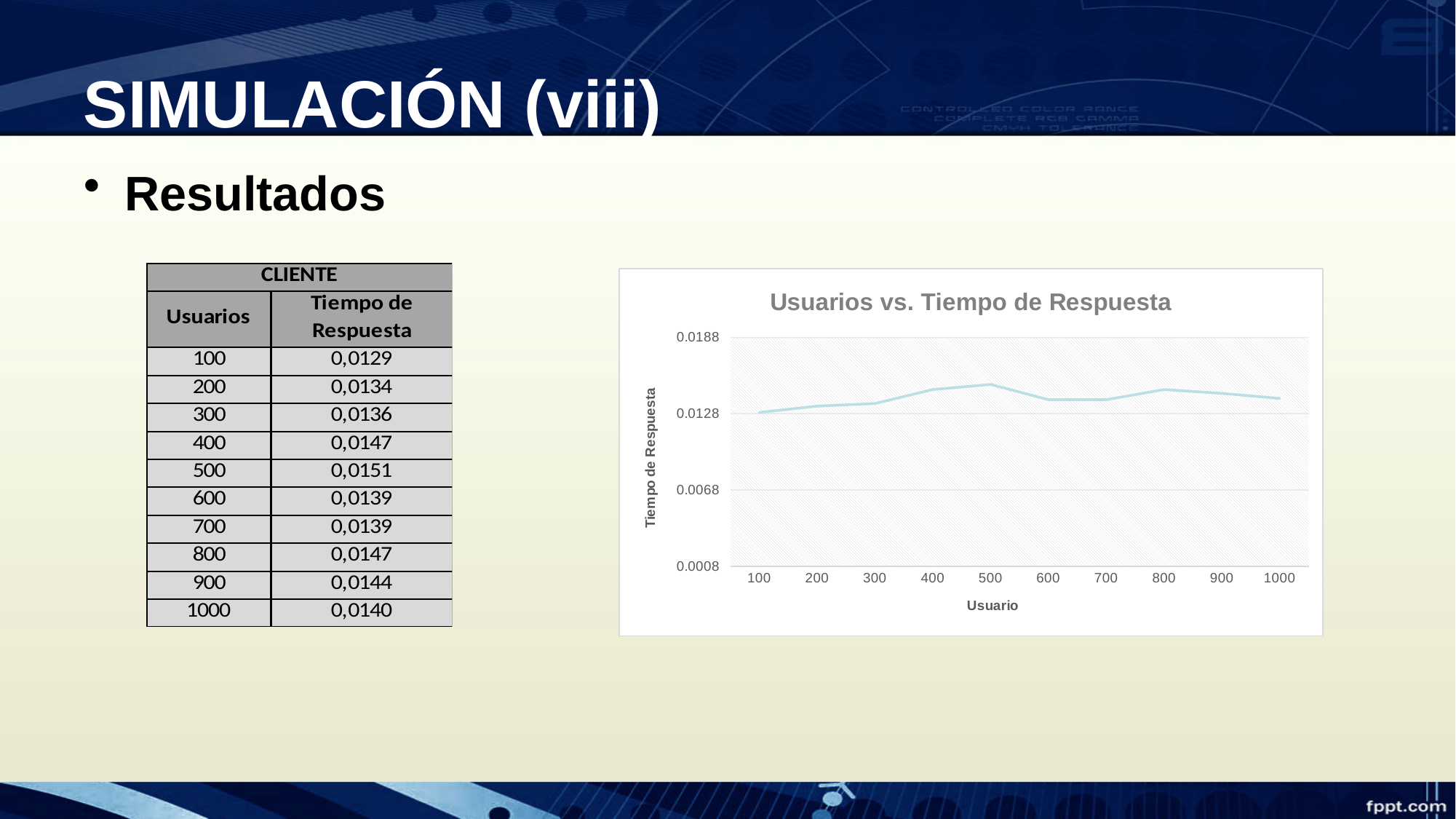
What is the difference between the Tiempo de Respuesta at 500 Usuarios and at 100 Usuarios? 0,0022 What is the title of the chart? Usuarios vs. Tiempo de Respuesta What kind of chart is shown on the slide? line chart At which number of Usuarios is the Tiempo de Respuesta lowest? 100 What is the label of the vertical axis of the chart? Tiempo de Respuesta Is the Tiempo de Respuesta at 500 Usuarios greater or less than 0.0128? greater According to the table, what is the Tiempo de Respuesta for 500 Usuarios? 0,0151 Which has a larger Tiempo de Respuesta, 500 Usuarios or 100 Usuarios? 500 Usuarios How many data points are plotted on the line chart? 10 Does the Tiempo de Respuesta rise or fall from 100 to 500 Usuarios? rise According to the table, what is the Tiempo de Respuesta for 1000 Usuarios? 0,0140 At which number of Usuarios is the Tiempo de Respuesta highest? 500